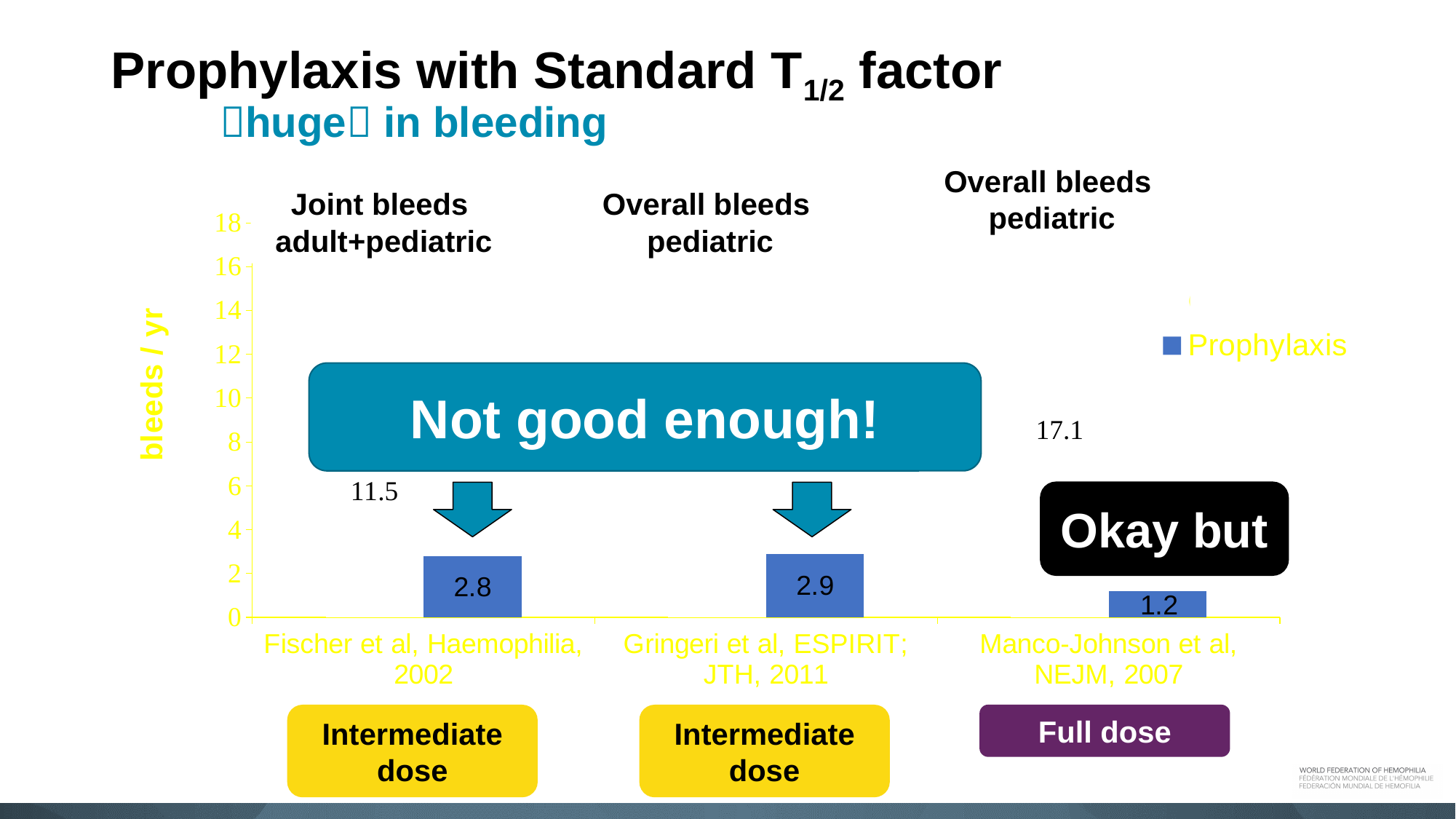
What is the Prophylaxis value for Manco-Johnson et al, NEJM, 2007? 1.2 Is the Prophylaxis value for Manco-Johnson et al, NEJM, 2007 greater or less than 2? less How many studies (categories) are shown on the x axis? 3 What is the difference between the Prophylaxis values for Gringeri et al, ESPIRIT; JTH, 2011 and Manco-Johnson et al, NEJM, 2007? 1.7 Which has a larger Prophylaxis value: Fischer et al, Haemophilia, 2002 or Manco-Johnson et al, NEJM, 2007? Fischer et al, Haemophilia, 2002 What is the difference between the Prophylaxis values for Fischer et al, Haemophilia, 2002 and Manco-Johnson et al, NEJM, 2007? 1.6 What is the Prophylaxis value for Gringeri et al, ESPIRIT; JTH, 2011? 2.9 What kind of chart is shown on the slide? bar chart What is the label on the y axis? bleeds / yr Which study has the lowest Prophylaxis value? Manco-Johnson et al, NEJM, 2007 What is the Prophylaxis value for Fischer et al, Haemophilia, 2002? 2.8 What is the highest tick value shown on the y axis? 18